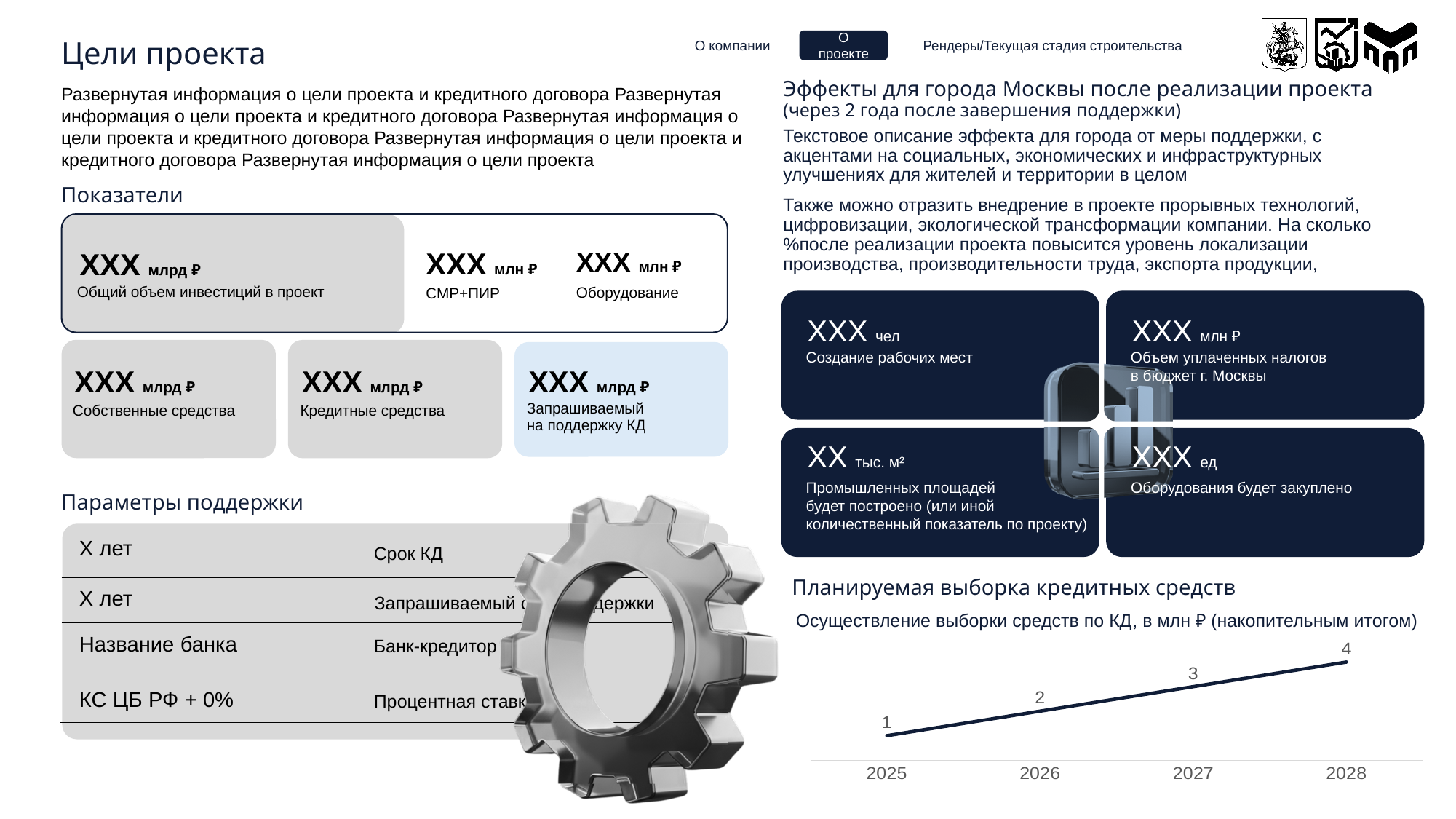
In the "Планируемая выборка кредитных средств" chart, what is the value for 2025? 1 In the "Планируемая выборка кредитных средств" chart, do the values rise or fall from 2025 to 2028? rise How many data points are plotted in the "Планируемая выборка кредитных средств" chart? 4 In the "Планируемая выборка кредитных средств" chart, what is the value for 2028? 4 In the "Планируемая выборка кредитных средств" chart, which year has the highest value? 2028 In the "Планируемая выборка кредитных средств" chart, which year has the lowest value? 2025 In the "Планируемая выборка кредитных средств" chart, what is the value for 2026? 2 In the "Планируемая выборка кредитных средств" chart, what is the difference between the values for 2028 and 2025? 3 In the "Планируемая выборка кредитных средств" chart, what is the value for 2027? 3 In the "Планируемая выборка кредитных средств" chart, which is larger: the value for 2027 or the value for 2026? 2027 What type of chart is shown under the heading "Планируемая выборка кредитных средств"? line chart What unit is stated in the subtitle of the "Планируемая выборка кредитных средств" chart? млн ₽